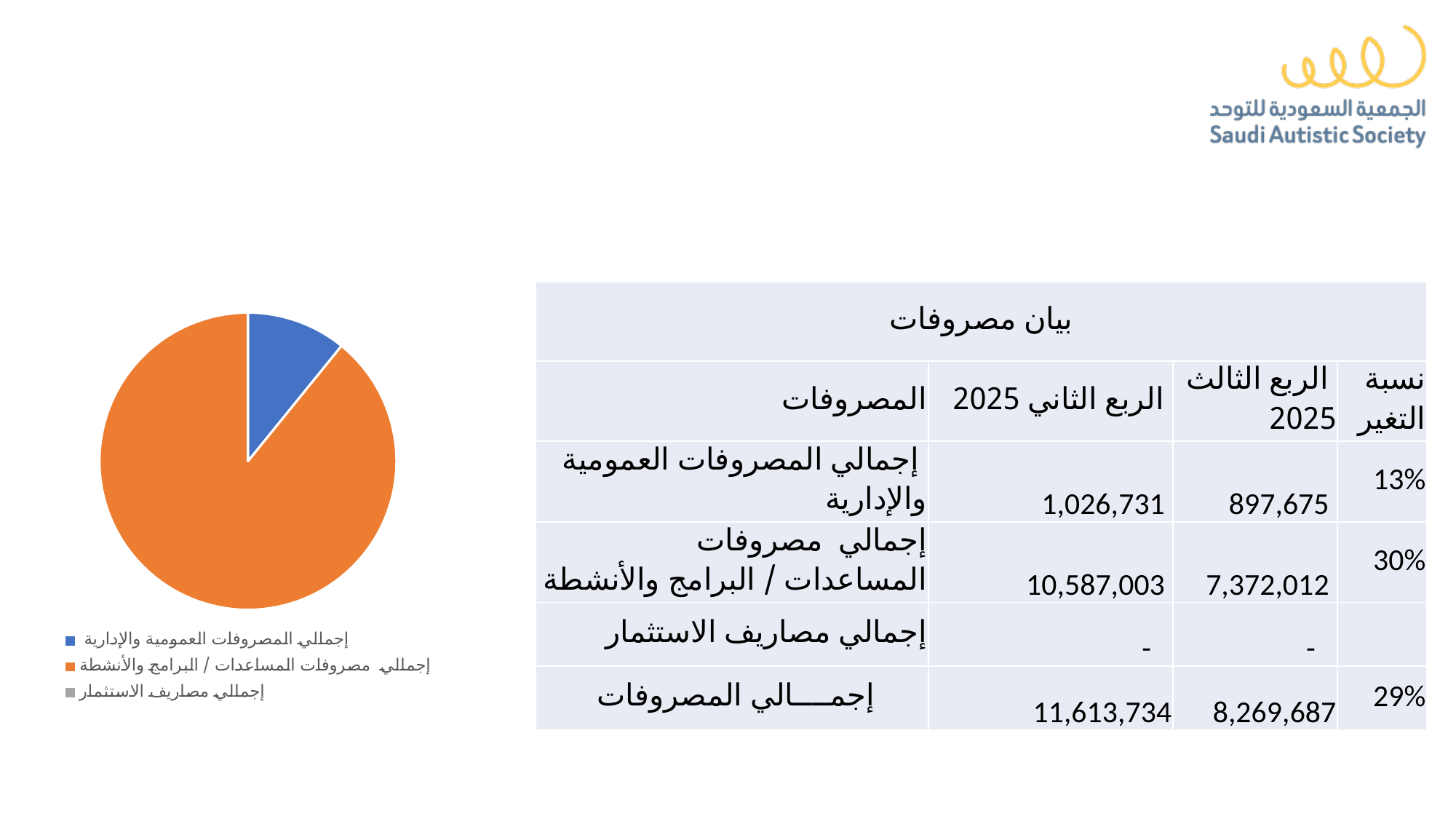
How many slices are visibly drawn in the pie chart? 2 What colour is the slice for إجمالي المصروفات العمومية والإدارية in the pie chart? blue Which category has the largest slice in the pie chart? إجمالي مصروفات المساعدات / البرامج والأنشطة What colour is the slice for إجمالي مصروفات المساعدات / البرامج والأنشطة in the pie chart? orange How many entries does the legend of the pie chart list? 3 What kind of chart is shown on the left of the slide? pie chart Which of the two visible slices in the pie chart is larger: إجمالي المصروفات العمومية والإدارية or إجمالي مصروفات المساعدات / البرامج والأنشطة? إجمالي مصروفات المساعدات / البرامج والأنشطة Which legend entry of the pie chart has no visible slice in the pie? إجمالي مصاريف الاستثمار